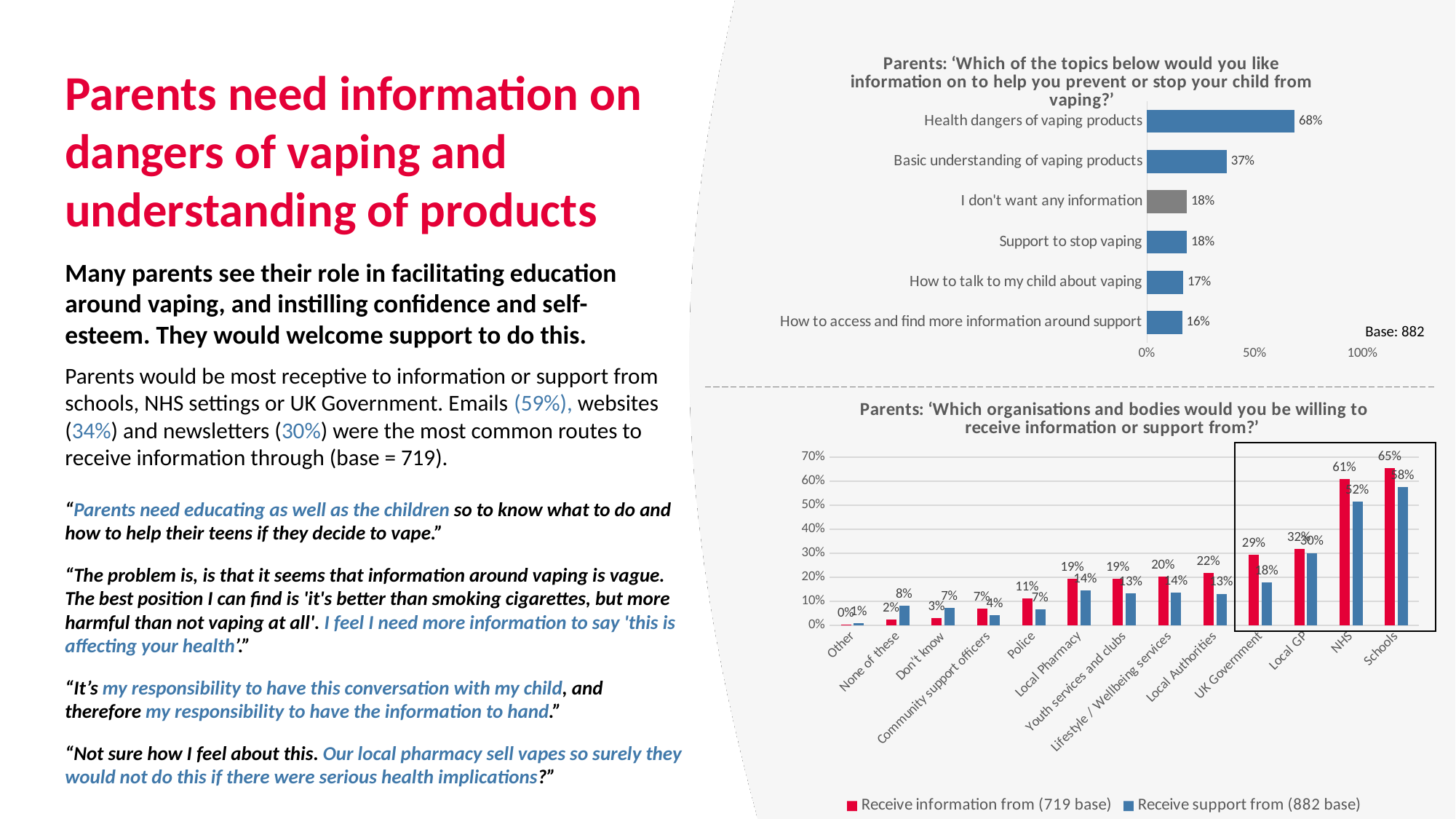
In the top chart, what percentage of parents chose 'Basic understanding of vaping products'? 37% What type of chart is the top chart? Bar chart In the bottom chart, which organisation has the highest value for 'Receive information from'? Schools How many topics are listed in the top chart? 6 In the bottom chart ('Which organisations and bodies would you be willing to receive information or support from?'), what percentage of parents would receive information from Schools? 65% In the top chart, which topic has the lowest percentage? How to access and find more information around support In the top chart, what is the difference between 'Health dangers of vaping products' and 'Basic understanding of vaping products'? 31 percentage points In the bottom chart, what is the difference between 'Receive information from' and 'Receive support from' for UK Government? 11 percentage points In the bottom chart, which is larger for Local Authorities: 'Receive information from' or 'Receive support from'? Receive information from In the top chart ('Which of the topics below would you like information on...'), what percentage of parents chose 'Health dangers of vaping products'? 68% How many series does the legend of the bottom chart list? 2 In the bottom chart, what percentage of parents would receive information from the NHS? 61%